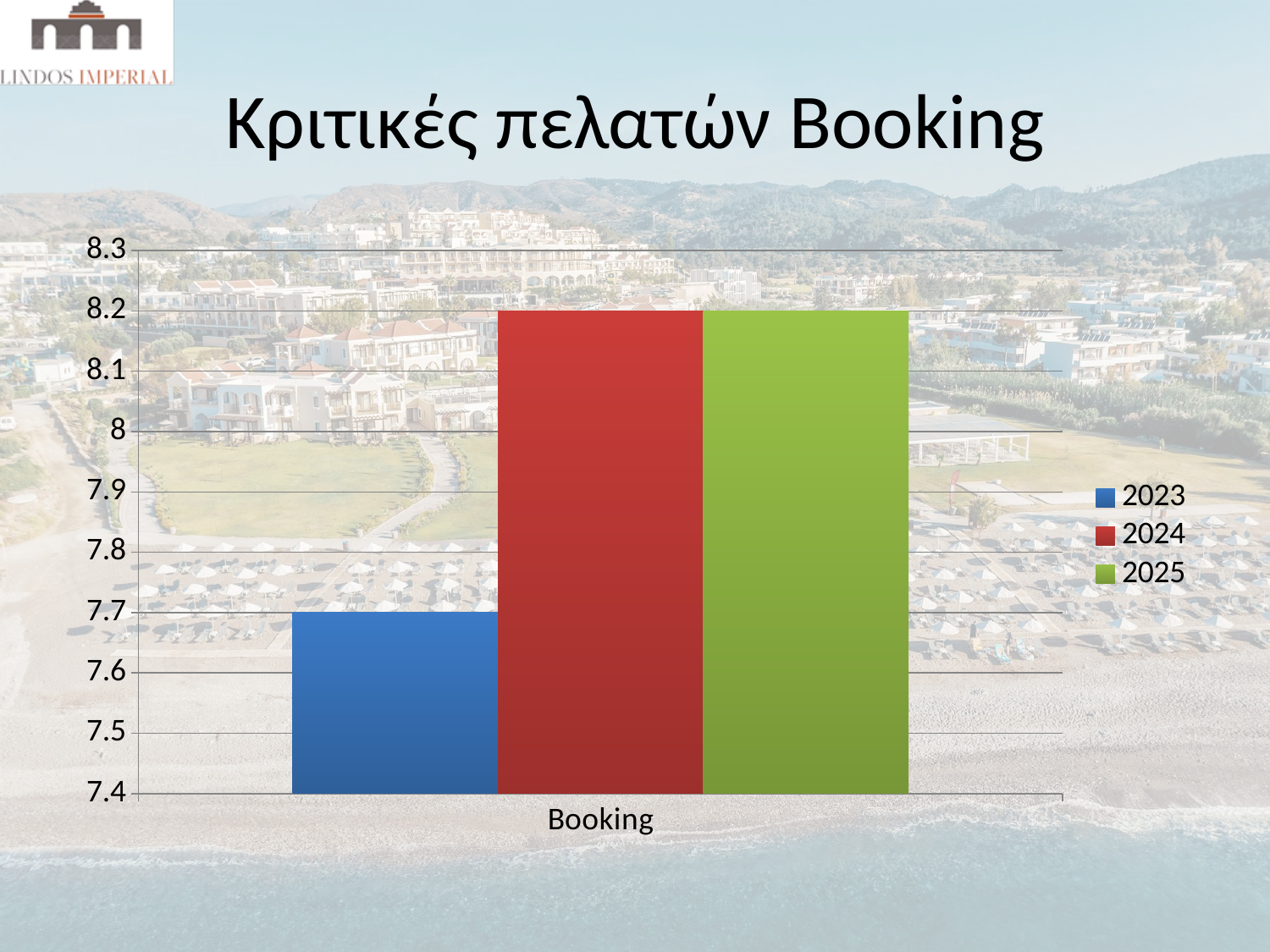
Which is larger, the Booking rating for 2023 or for 2024? 2024 What is the title of the slide containing the chart? Κριτικές πελατών Booking How many series does the legend list? 3 What kind of chart is shown on the slide? bar chart Which year has the lowest Booking rating? 2023 What is the Booking rating for 2024? 8.2 Is the Booking rating for 2023 greater or less than 8? less What is the difference between the Booking rating for 2024 and for 2023? 0.5 Is the Booking rating for 2025 greater or less than 8? greater What is the Booking rating for 2025? 8.2 How many categories are shown on the x axis? 1 What is the Booking rating for 2023? 7.7